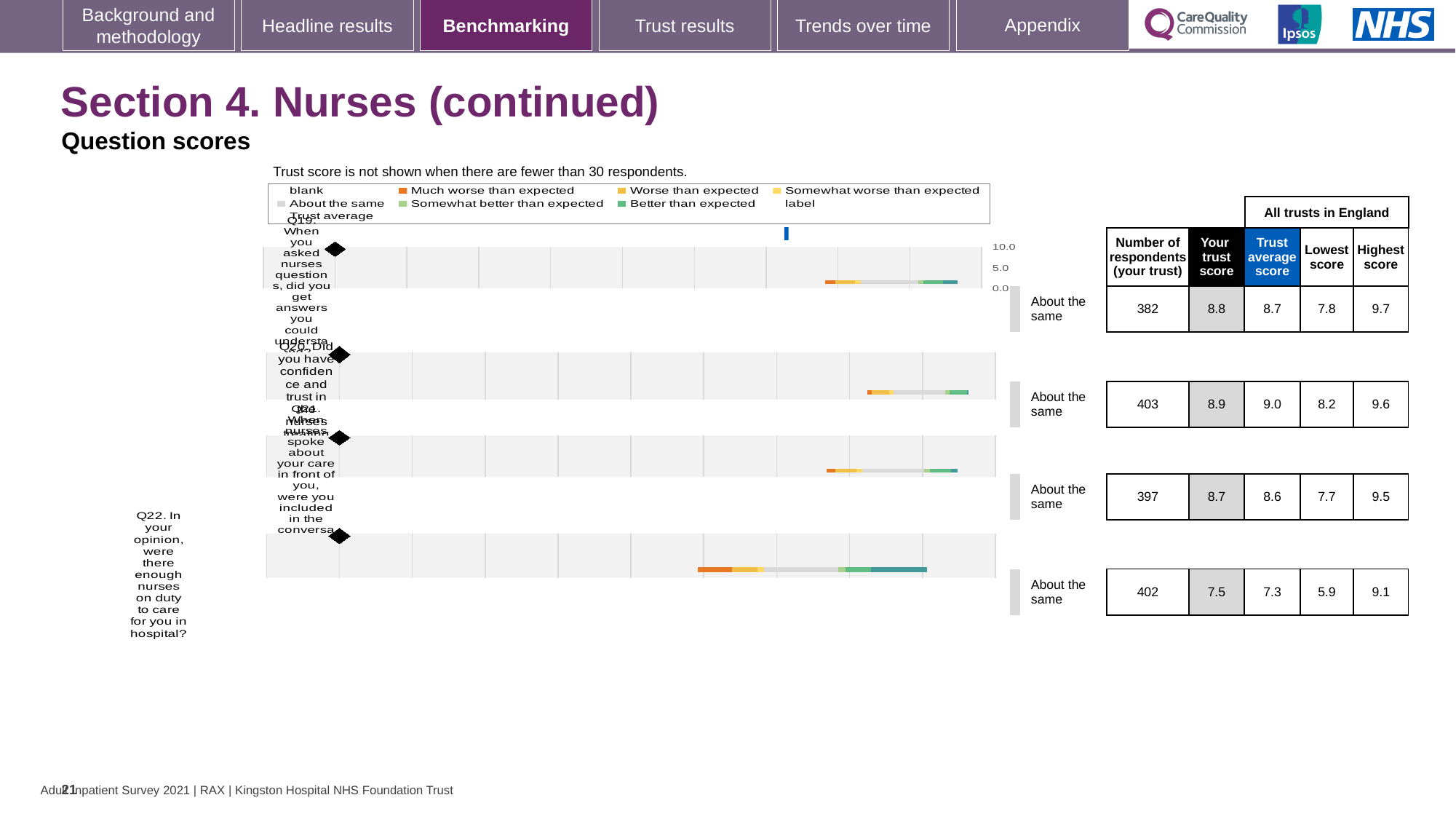
What is the lowest score across all trusts in England for Q21? 7.7 According to the note above the chart, when is the trust score not shown? When there are fewer than 30 respondents For Q19, which is larger: your trust score or the trust average score? Your trust score How many respondents from your trust answered Q22 (were there enough nurses on duty)? 402 Which question has the lowest 'Your trust score'? Q22 What kind of chart is used to show the question scores on this slide? bar chart What benchmark category is shown next to Q20? About the same What is the trust average score for Q20 (Did you have confidence and trust in the nurses treating you)? 9.0 Which question has the highest 'Your trust score'? Q20 What is the 'Your trust score' for Q19 (When you asked nurses questions, did you get answers you could understand)? 8.8 How many questions (Q19 to Q22) are plotted in the chart? 4 For Q22, what is the difference between the highest score and the lowest score across all trusts in England? 3.2